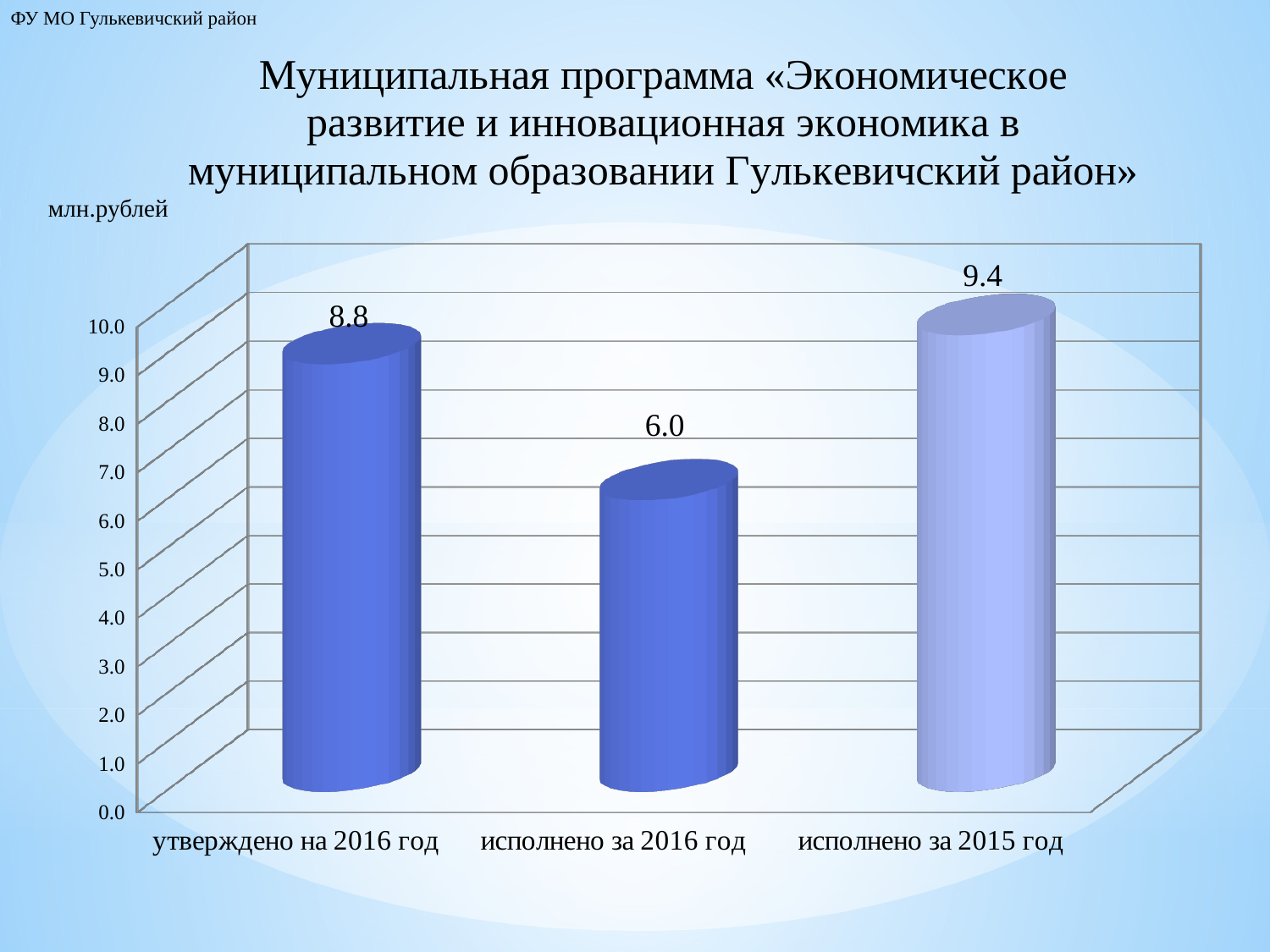
What kind of chart is shown on the slide? bar chart What is the value for «исполнено за 2015 год»? 9.4 What unit is indicated above the chart? млн.рублей What is the difference between the values for «утверждено на 2016 год» and «исполнено за 2016 год»? 2.8 Is the value for «исполнено за 2016 год» greater or less than 7.0? less How many categories are shown on the chart? 3 What is the value for «исполнено за 2016 год»? 6.0 Which is larger: the value for «утверждено на 2016 год» or for «исполнено за 2015 год»? исполнено за 2015 год What is the difference between the values for «исполнено за 2015 год» and «исполнено за 2016 год»? 3.4 Which category has the highest value? исполнено за 2015 год Which category has the lowest value? исполнено за 2016 год What is the value for «утверждено на 2016 год»? 8.8